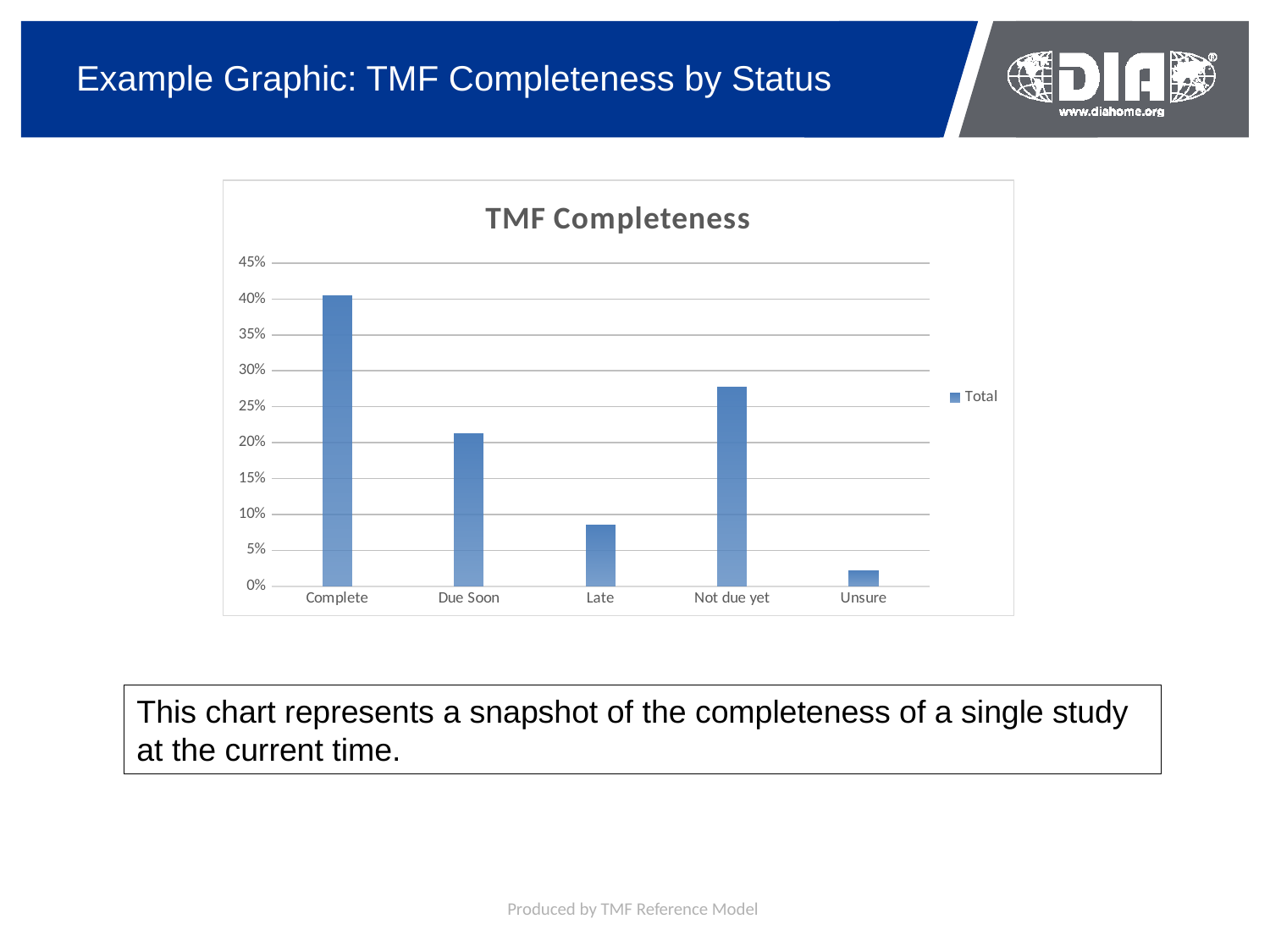
Which category has the highest value in the chart? Complete What is the name of the series shown in the chart legend? Total What is the title of the chart? TMF Completeness What type of chart is shown on the slide? bar chart Is the value for Due Soon greater or less than 20%? greater Is the value for Not due yet greater or less than 30%? less Which is larger, the value for Due Soon or the value for Not due yet? Not due yet How many series does the chart legend list? 1 Which category has the lowest value in the chart? Unsure Is the value for Late greater or less than 10%? less How many categories are shown on the x axis of the chart? 5